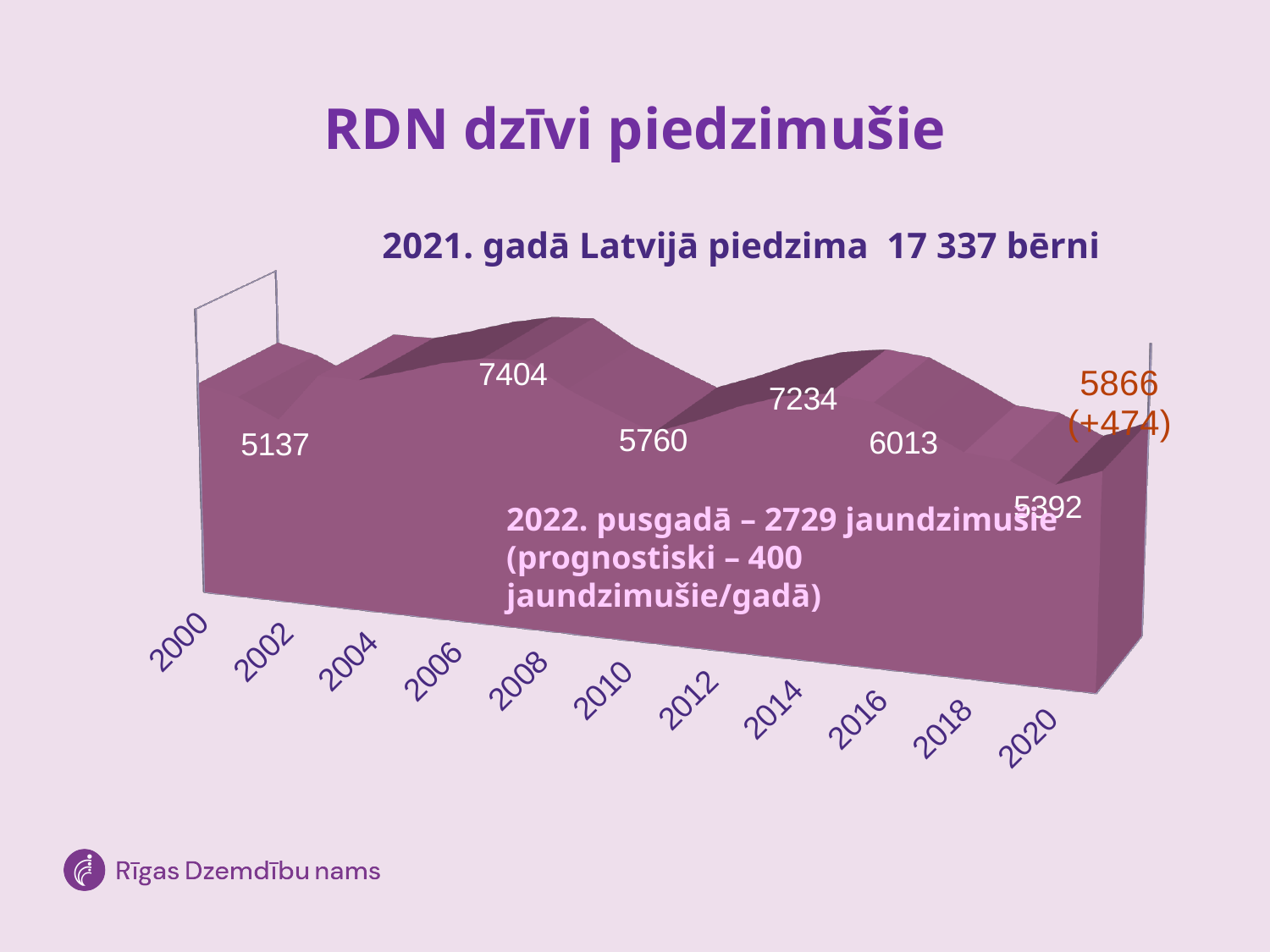
Does the plotted area rise or fall from 2000 to 2006? rise How many year labels are shown on the x axis of the chart? 11 What is the highest value printed as a data label on the chart? 7404 What is the rightmost data label shown on the chart, printed in orange? 5866 (+474) What is the difference between the data labels 7234 and 6013? 1221 What kind of chart is shown on the slide? area chart What is the title of the chart on the slide? RDN dzīvi piedzimušie What is the difference between the data labels 5866 and 5392? 474 What is the leftmost data label shown on the chart? 5137 What is the difference between the data labels 7404 and 5137? 2267 What is the lowest value printed as a data label on the chart? 5137 Which is larger, the data label 7404 or the data label 7234? 7404